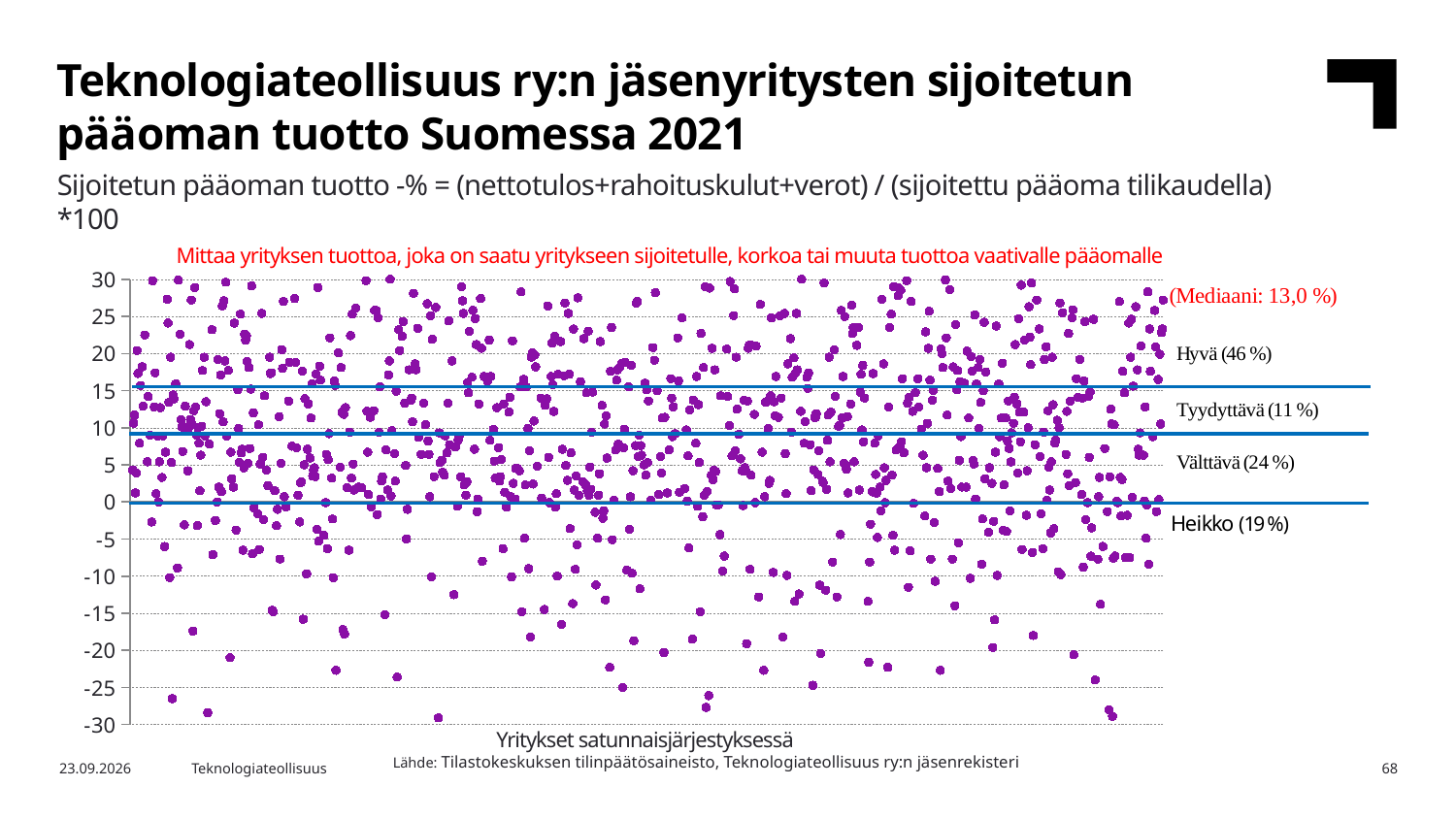
How many rating categories are labelled on the right side of the chart? 4 What share of companies falls into the Välttävä category? 24 % What share of companies falls into the Heikko category? 19 % What share of companies falls into the Tyydyttävä category? 11 % Which category (Hyvä, Tyydyttävä, Välttävä, Heikko) has the largest share of companies? Hyvä What kind of chart is shown on the slide? scatter plot What is the label of the x axis? Yritykset satunnaisjärjestyksessä Which has a larger share of companies, Välttävä or Heikko? Välttävä What is the difference in percentage points between the Hyvä share and the Heikko share? 27 What is the median (Mediaani) value shown on the chart? 13,0 % What share of companies falls into the Hyvä category? 46 % Which category (Hyvä, Tyydyttävä, Välttävä, Heikko) has the smallest share of companies? Tyydyttävä